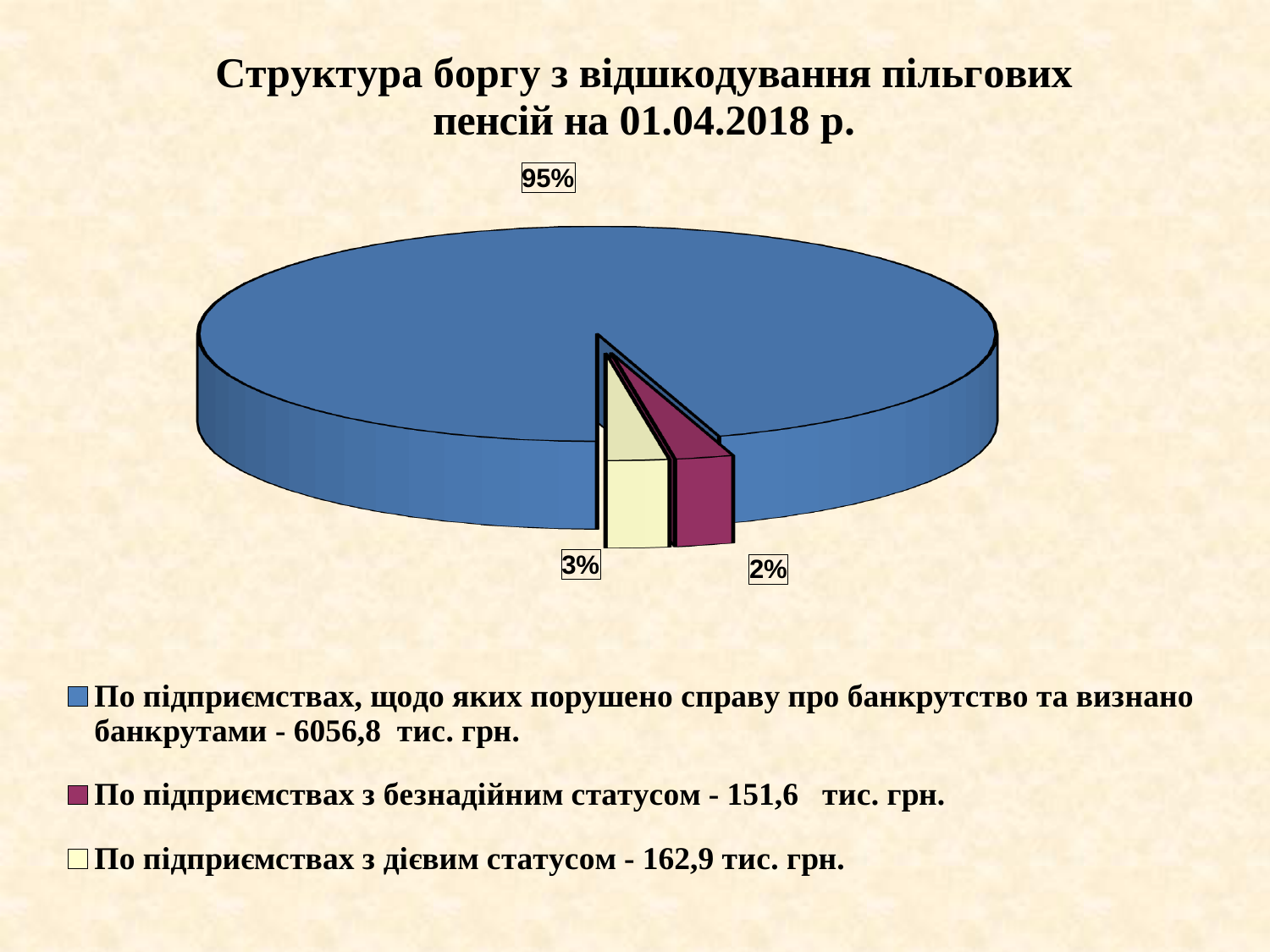
According to the legend, what is the debt amount for enterprises with active status (По підприємствах з дієвим статусом)? 162,9 тис. грн. What share of the pie is taken by enterprises against which bankruptcy proceedings were opened and which were declared bankrupt (По підприємствах, щодо яких порушено справу про банкрутство та визнано банкрутами)? 95% Which is larger: the share for enterprises with active status (3%) or the share for enterprises with hopeless status (2%)? По підприємствах з дієвим статусом What kind of chart is shown on the slide? pie chart What share of the pie is taken by enterprises with hopeless status (По підприємствах з безнадійним статусом)? 2% According to the legend, what is the debt amount for enterprises with hopeless status (По підприємствах з безнадійним статусом)? 151,6 тис. грн. How many entries does the legend list? 3 What is the title of the chart? Структура боргу з відшкодування пільгових пенсій на 01.04.2018 р. How many slices does the pie chart have? 3 What share of the pie is taken by enterprises with active status (По підприємствах з дієвим статусом)? 3% Which category has the largest slice of the pie? По підприємствах, щодо яких порушено справу про банкрутство та визнано банкрутами Which category has the smallest slice of the pie? По підприємствах з безнадійним статусом